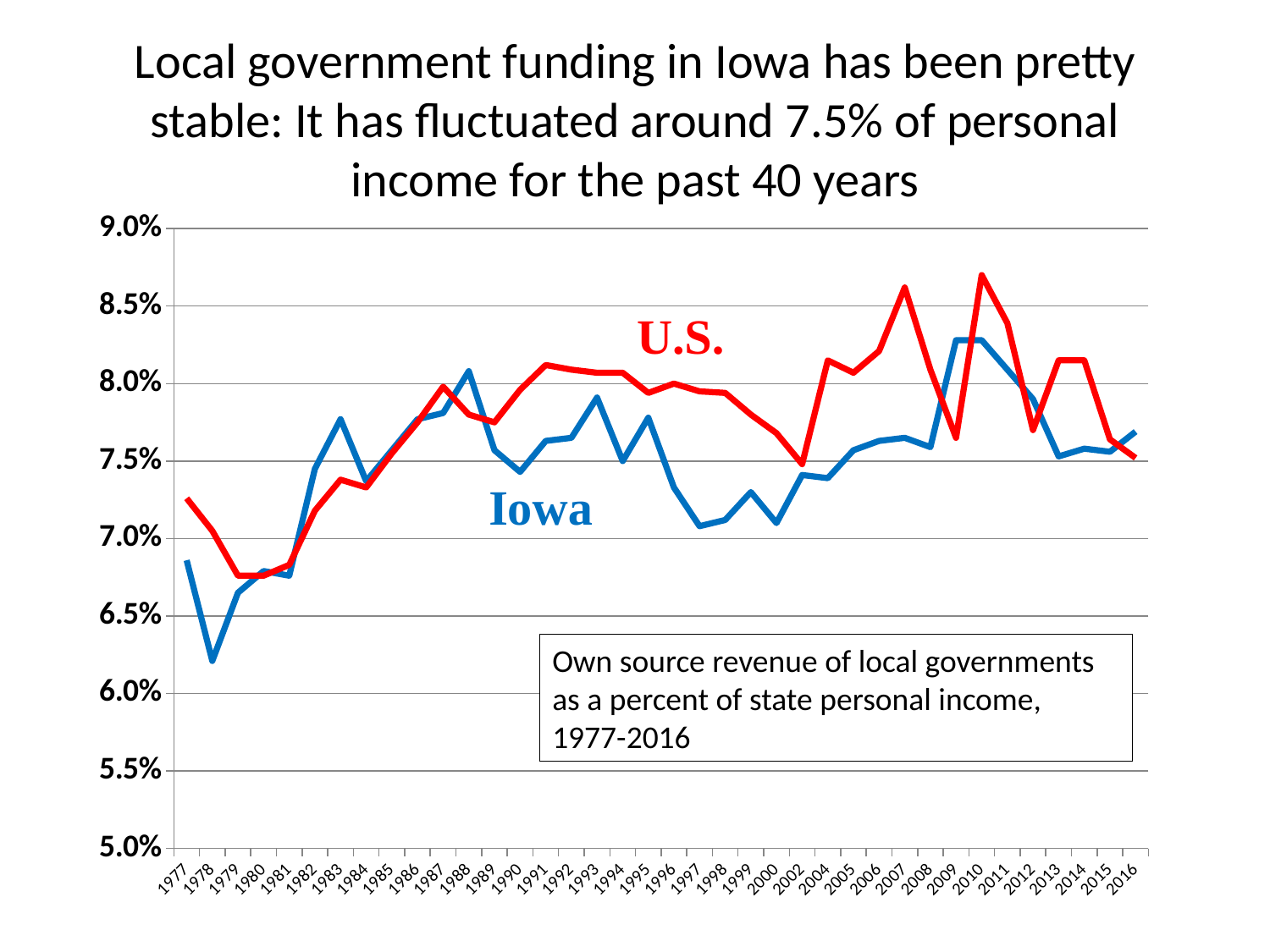
In 1988, which is larger, the U.S. value or the Iowa value? Iowa Is the U.S. value for 2010 greater or less than 8.5%? greater In 1997, which is larger, the U.S. value or the Iowa value? U.S. In which year is the Iowa value lowest? 1978 Which series is drawn in red? U.S. Is the Iowa value for 1978 greater or less than 6.5%? less Is the Iowa value for 2009 greater or less than 8.0%? greater Does the Iowa line rise or fall from 1978 to 1983? rise In which year is the U.S. value highest? 2010 How many series are plotted on the chart? 2 What kind of chart is shown on the slide? line chart What range of years does the chart cover, according to the text box? 1977-2016